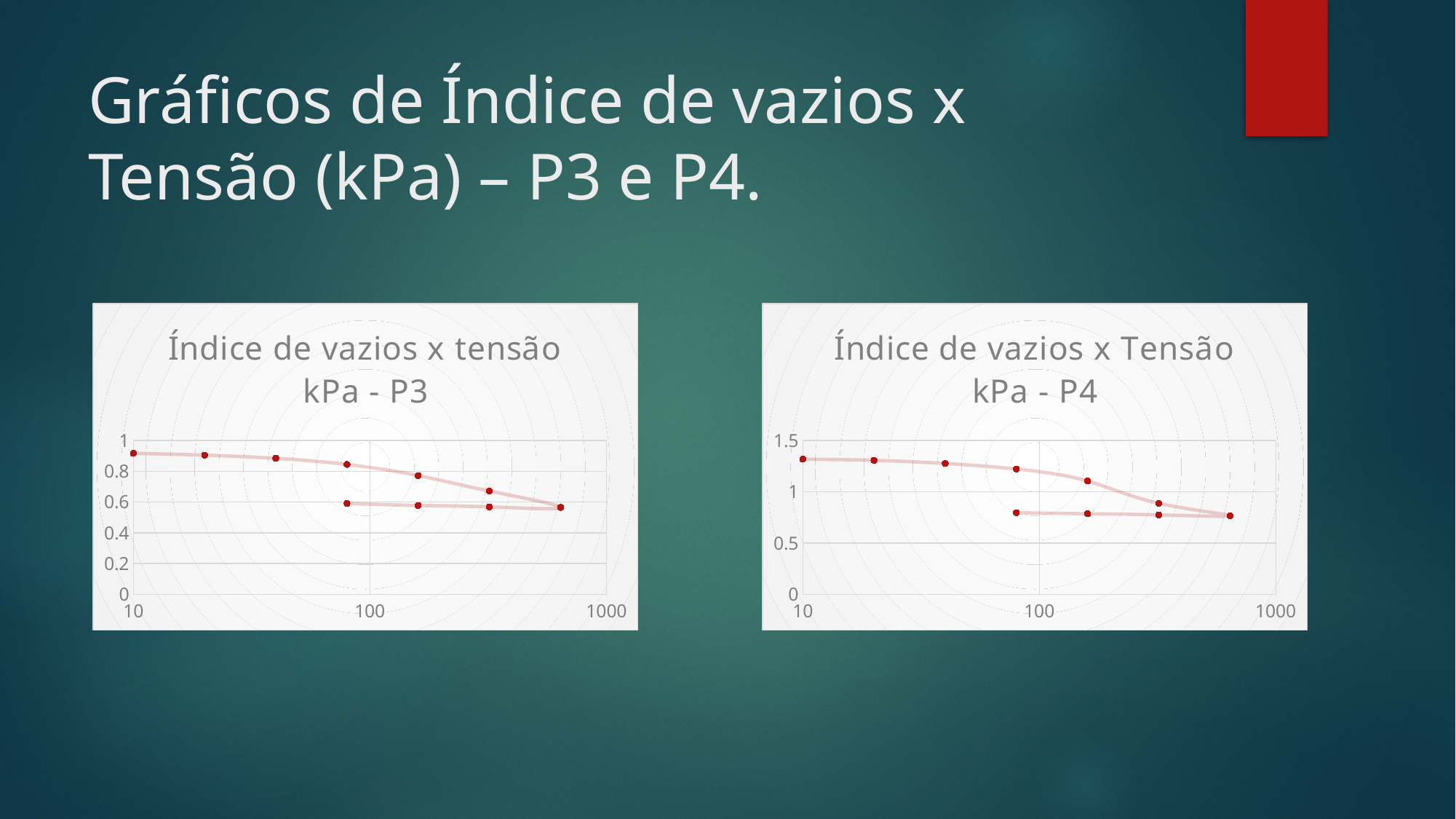
On the right chart (P4), is the value of the lowest point greater or less than 1? less How many data points are plotted on the right chart (P4)? 10 On the right chart (P4), does the void index rise or fall as the tension increases along the upper curve? fall What kind of chart is the left chart titled "Índice de vazios x tensão kPa - P3"? line chart What are the tick labels shown on the x axis of the left chart (P3)? 10, 100, 1000 On the right chart (P4), is the value of the leftmost point, at 10 kPa, greater or less than 1? greater On the left chart (P3), does the void index rise or fall as the tension increases along the upper curve? fall On the left chart (P3), is the value of the lowest point greater or less than 0.8? less What is the highest value shown on the y axis of the right chart (P4)? 1.5 How many data points are plotted on the left chart (P3)? 10 Which is larger: the value of the leftmost point on the P4 chart or the leftmost point on the P3 chart? P4